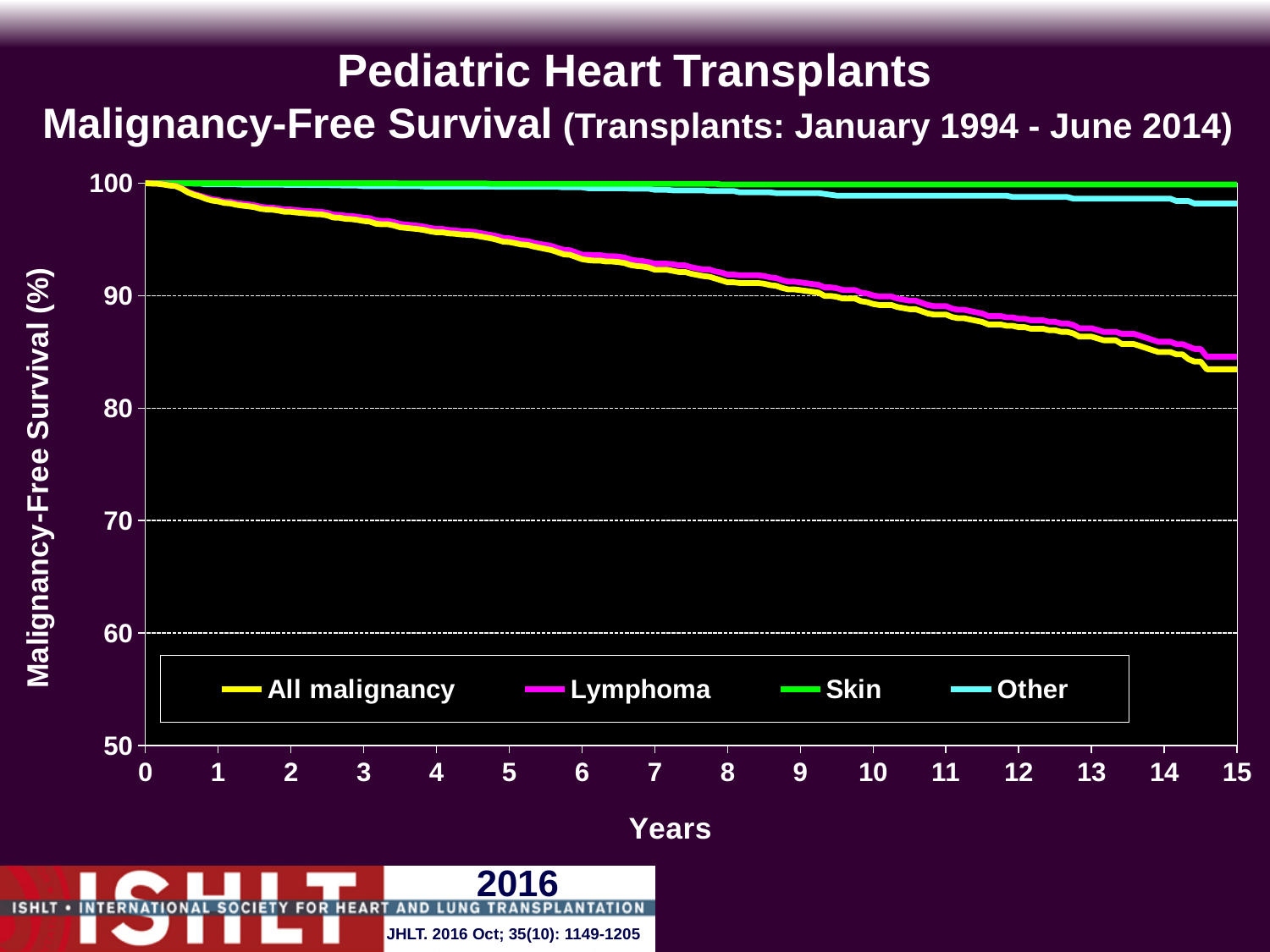
At 15 years, which is higher: Skin or All malignancy? Skin What is the label of the y axis? Malignancy-Free Survival (%) What kind of chart is shown on the slide? Line chart At 15 years, which is lower: Skin or Other? Other Is the value for All malignancy at 15 years greater or less than 80? greater Is the value for All malignancy at 15 years greater or less than 90? less Which series are listed in the legend? All malignancy, Lymphoma, Skin, Other Is the value for Other at 15 years greater or less than 90? greater Does the All malignancy line rise or fall as years increase? Fall Which series has the highest malignancy-free survival at 15 years? Skin How many series does the legend list? 4